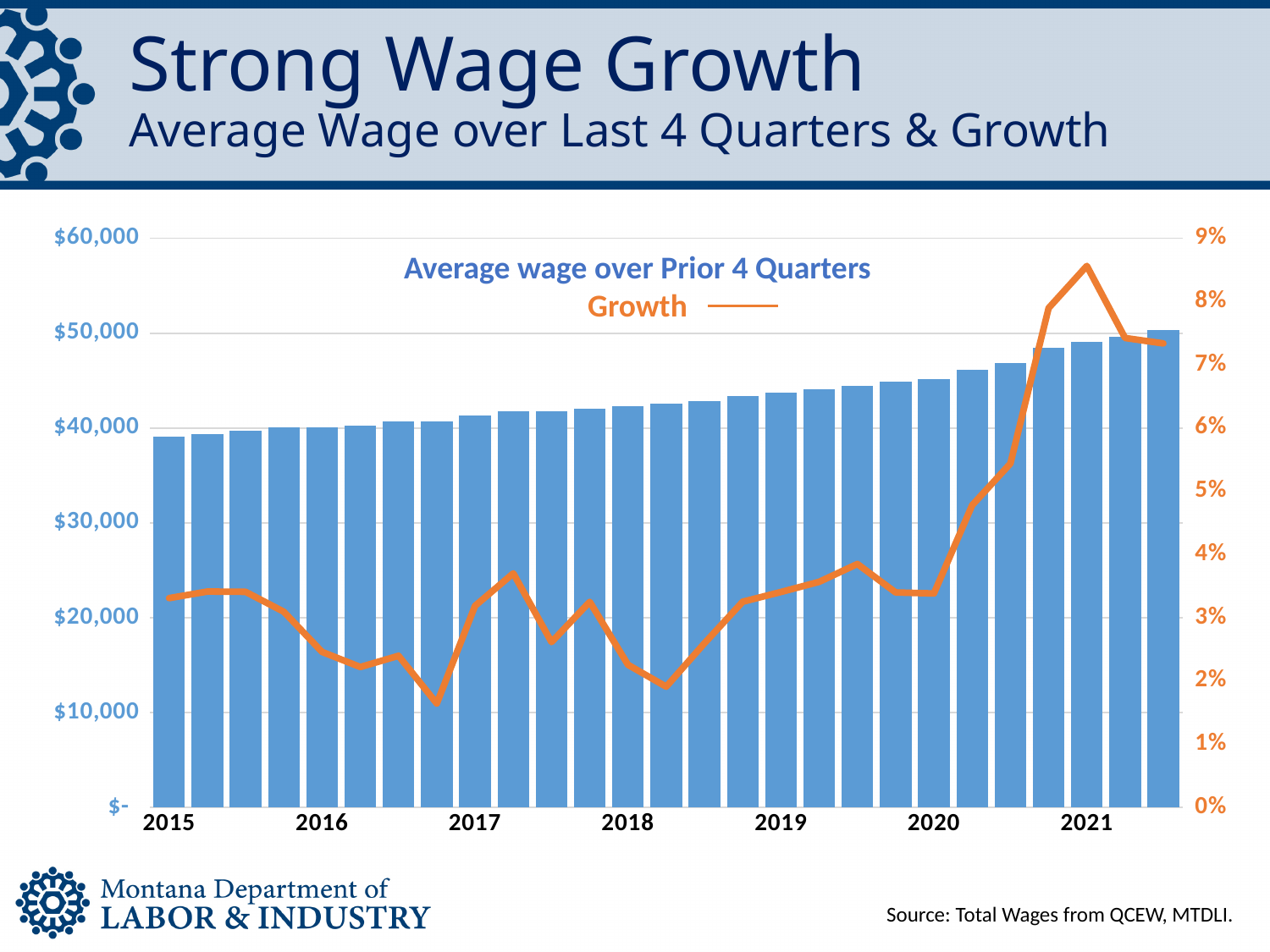
Which year labeled on the x axis has the lowest average wage bars? 2015 Do the average wage bars rise or fall from 2015 to 2021? Rise Is the Growth value at the start of 2018 greater or less than 3%? less Is the average wage at the end of 2021 greater or less than $40,000? greater Which year labeled on the x axis has the highest average wage bars? 2021 Is the peak of the Growth line in 2021 greater or less than 8%? greater What kind of chart is shown on the slide? A bar chart with a line Which series is drawn as an orange line? Growth Which series is shown as blue bars? Average wage over Prior 4 Quarters Which is larger, the average wage at the start of 2019 or at the start of 2017? 2019 How many series does the chart's legend list? 2